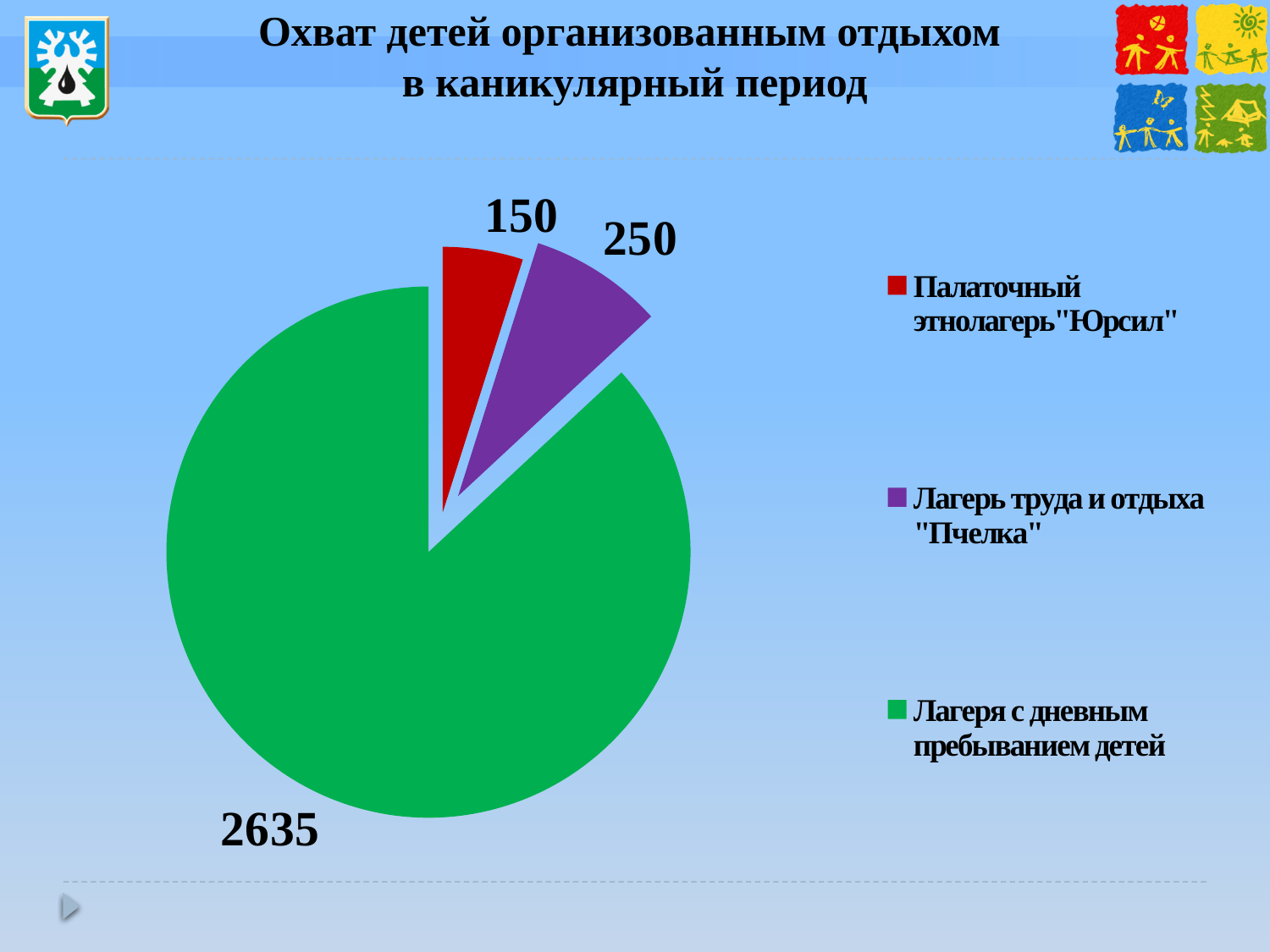
Which category has the largest slice of the pie? Лагеря с дневным пребыванием детей What is the total of all slices in the pie chart? 3035 Which category has the smallest slice of the pie? Палаточный этнолагерь "Юрсил" What is the value for Лагеря с дневным пребыванием детей? 2635 How many categories does the pie chart have? 3 What is the difference between the values for Лагерь труда и отдыха "Пчелка" and Палаточный этнолагерь "Юрсил"? 100 Which is larger: the value for Лагерь труда и отдыха "Пчелка" or the value for Палаточный этнолагерь "Юрсил"? Лагерь труда и отдыха "Пчелка" What colour is the slice for Лагеря с дневным пребыванием детей? Green What is the value for Палаточный этнолагерь "Юрсил"? 150 What type of chart is shown on the slide? Pie chart What is the difference between the values for Лагеря с дневным пребыванием детей and Лагерь труда и отдыха "Пчелка"? 2385 What is the value for Лагерь труда и отдыха "Пчелка"? 250